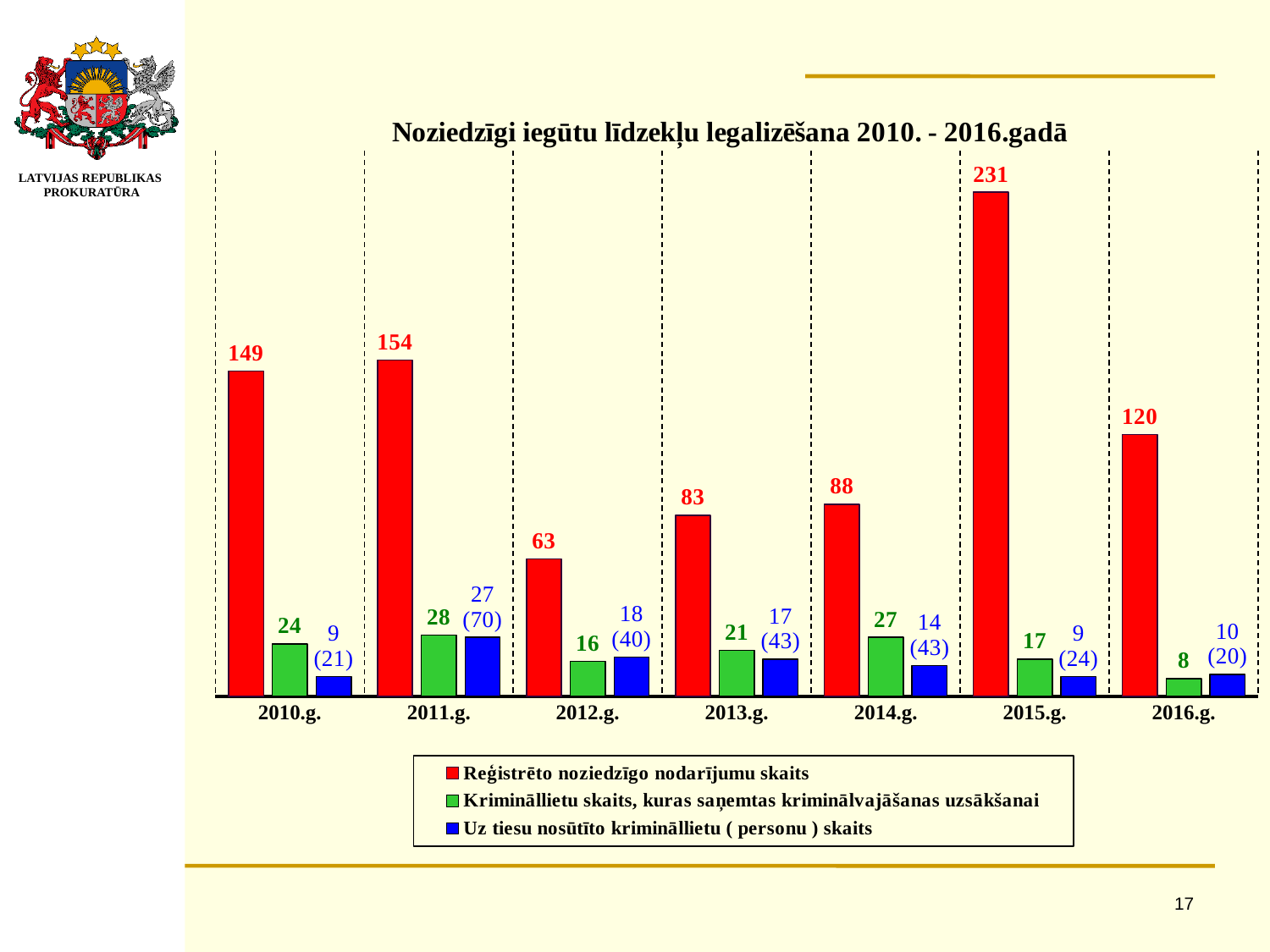
What kind of chart is shown on the slide? Bar chart What is the value of Reģistrēto noziedzīgo nodarījumu skaits for 2015.g.? 231 What is the value of Uz tiesu nosūtīto krimināllietu (personu) skaits for 2012.g.? 18 (40) In which year is Krimināllietu skaits, kuras saņemtas kriminālvajāšanas uzsākšanai the lowest? 2016.g. How many series does the legend list? 3 In which year is Reģistrēto noziedzīgo nodarījumu skaits the highest? 2015.g. What is the difference between Reģistrēto noziedzīgo nodarījumu skaits in 2015.g. and 2016.g.? 111 What is the value of Krimināllietu skaits, kuras saņemtas kriminālvajāšanas uzsākšanai for 2011.g.? 28 What is the title of the chart? Noziedzīgi iegūtu līdzekļu legalizēšana 2010. - 2016.gadā Which year has the larger Reģistrēto noziedzīgo nodarījumu skaits, 2010.g. or 2011.g.? 2011.g. How many years are shown on the x axis? 7 Does Reģistrēto noziedzīgo nodarījumu skaits rise or fall from 2011.g. to 2012.g.? Fall